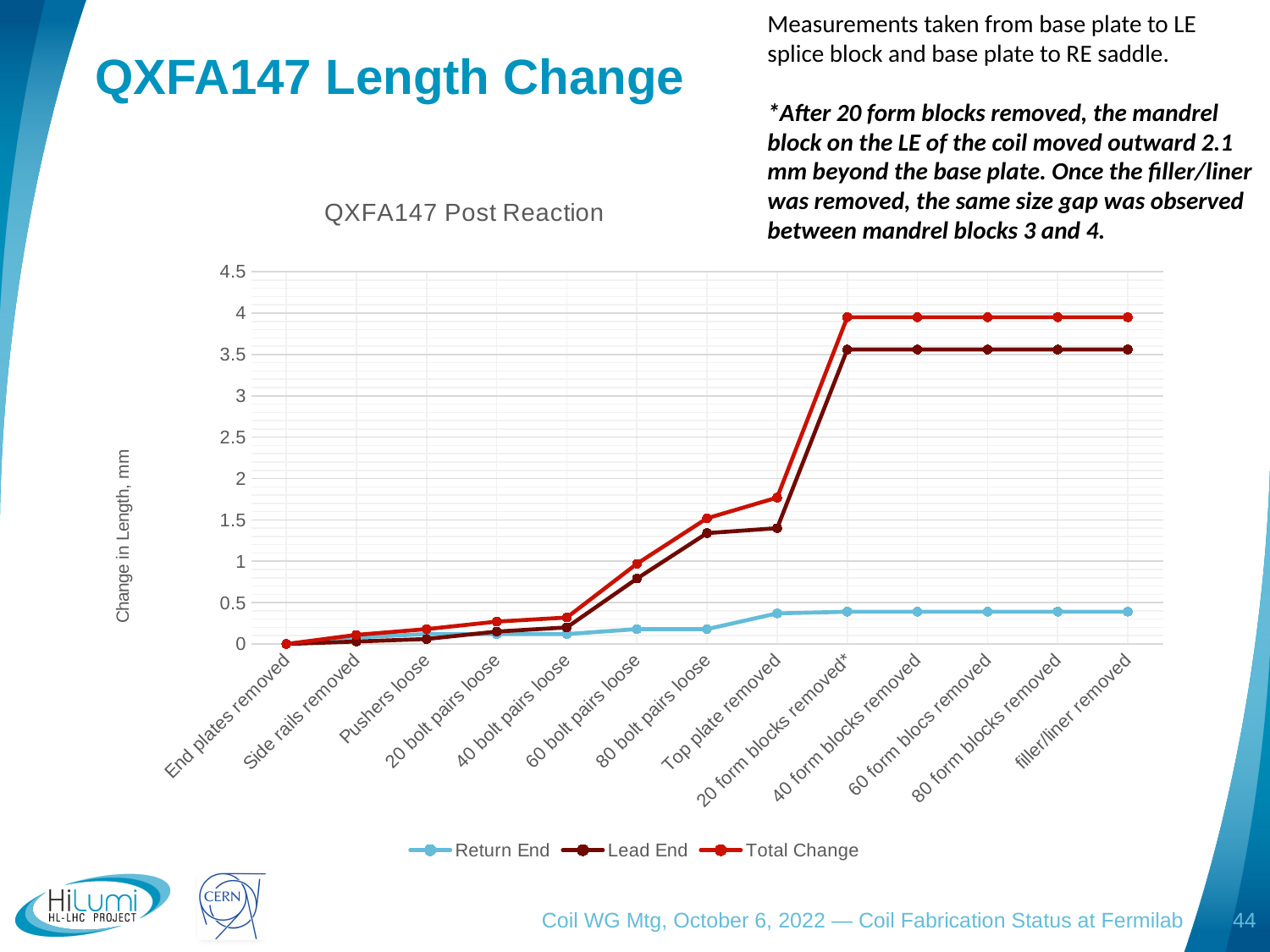
What kind of chart is shown on the slide? line chart How many categories are shown along the x axis of the chart? 13 Is the value for Return End at 'filler/liner removed' greater or less than 0.5? less Is the value for Total Change at 'filler/liner removed' greater or less than 3.5? greater Is the value for Total Change at 'Top plate removed' greater or less than 1.5? greater How many series does the chart legend list? 3 At 'Top plate removed', which is larger: the Lead End value or the Return End value? Lead End What is the title of the chart? QXFA147 Post Reaction Which series has the lowest value at '20 form blocks removed*'? Return End What is the label of the vertical axis of the chart? Change in Length, mm Which series has the highest value at 'filler/liner removed'? Total Change